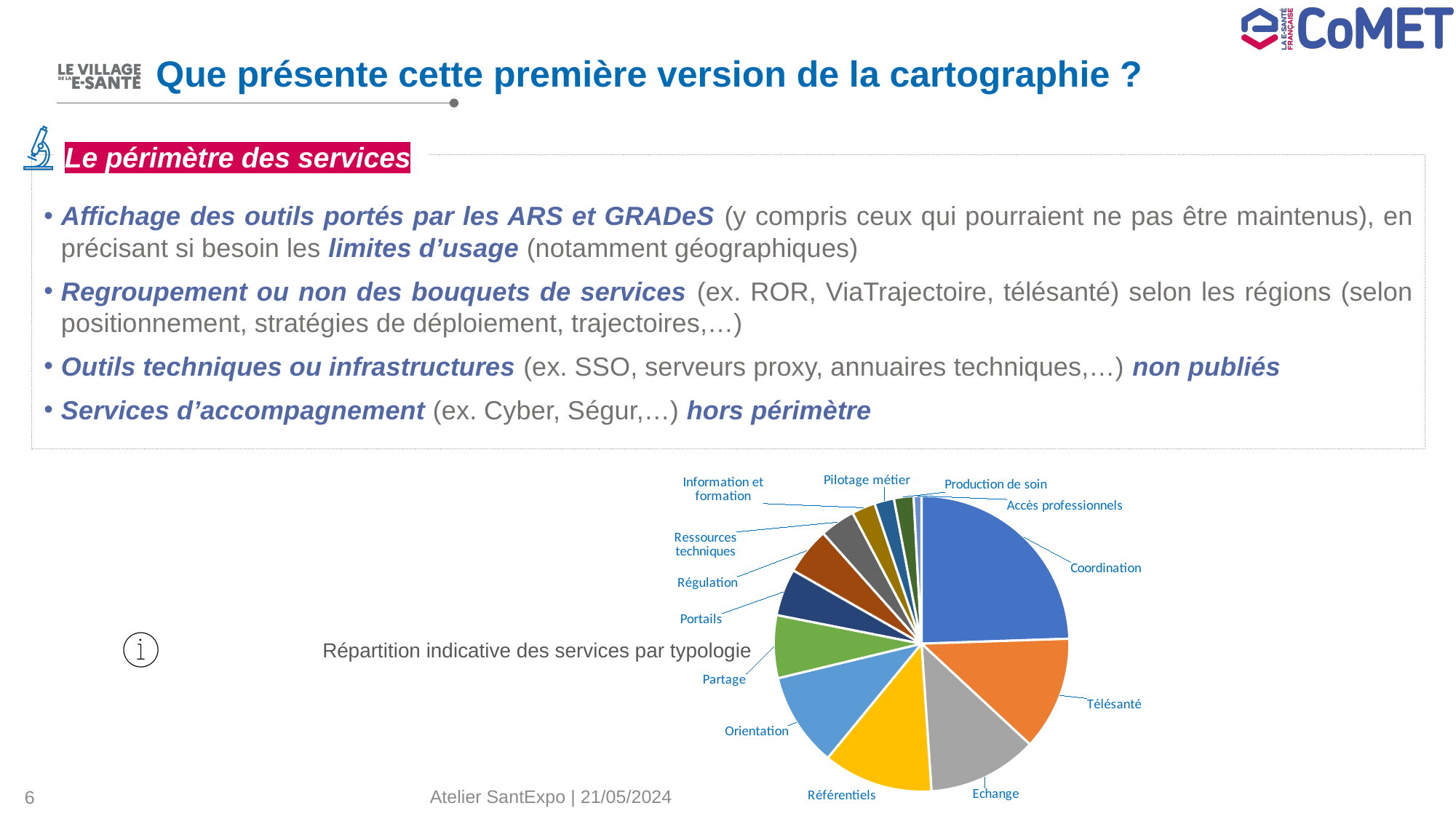
Which slice is larger in the pie chart, Portails or Accès professionnels? Portails Which category has the largest slice in the pie chart? Coordination How many categories (slices) does the pie chart have? 13 What kind of chart is shown at the bottom of the slide? pie chart Which slice is larger in the pie chart, Orientation or Ressources techniques? Orientation Which slice is larger in the pie chart, Référentiels or Régulation? Référentiels What colour is the Télésanté slice in the pie chart? orange What caption describes the pie chart on the slide? Répartition indicative des services par typologie